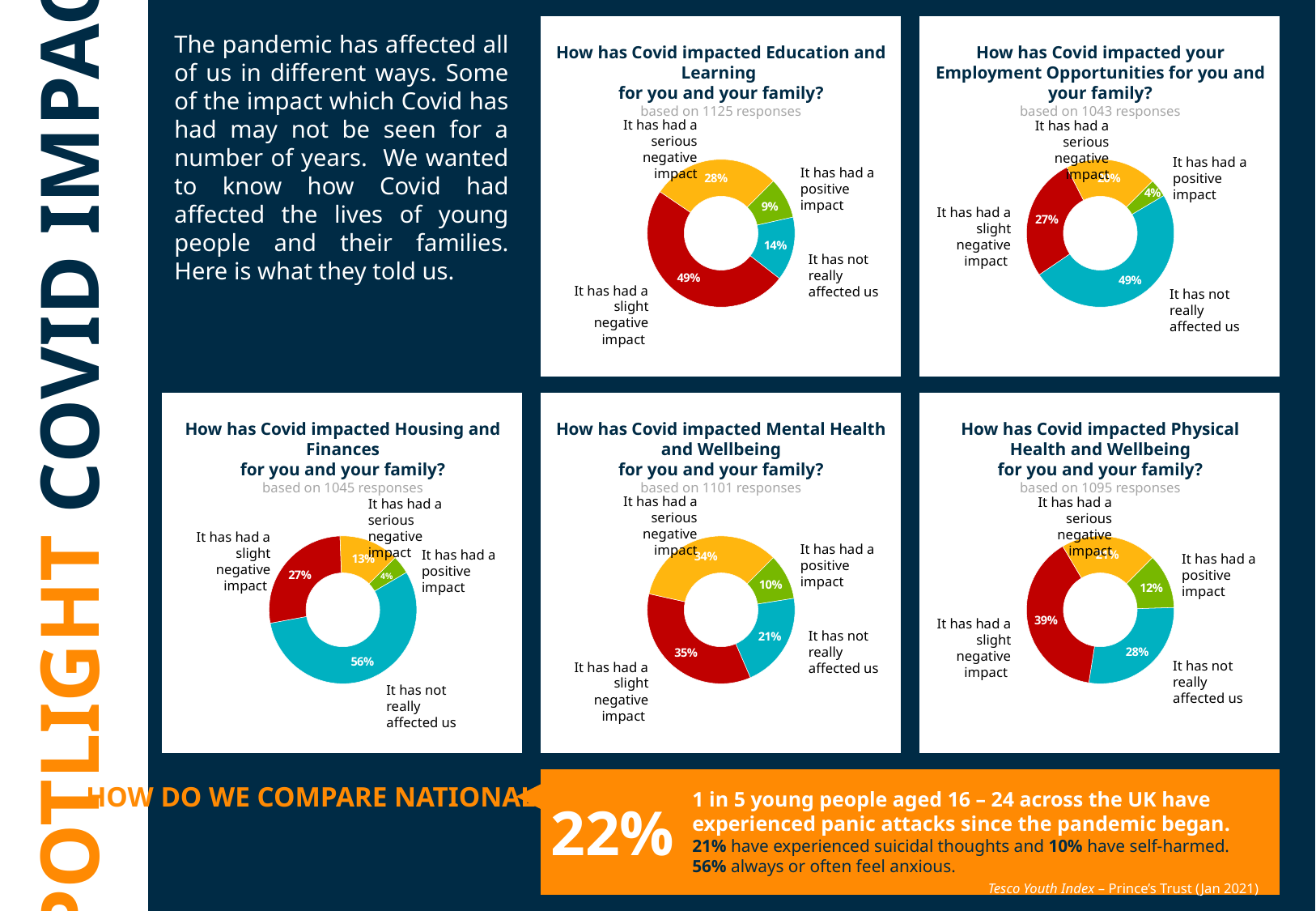
How many response categories does each donut chart on the slide show? 4 In the 'How has Covid impacted your Employment Opportunities' chart, which is larger: the share for 'It has not really affected us' or the share for 'It has had a slight negative impact'? It has not really affected us In the 'How has Covid impacted Mental Health and Wellbeing' chart, what percentage said it has not really affected them? 21% In the 'How has Covid impacted Physical Health and Wellbeing' chart, what percentage said it has had a positive impact? 12% What kind of chart is used for 'How has Covid impacted Housing and Finances'? Donut (pie) chart In the 'How has Covid impacted Physical Health and Wellbeing' chart, what is the difference between the slight negative impact share and the 'not really affected us' share? 11% In the 'How has Covid impacted Mental Health and Wellbeing' chart, what is the difference between the slight negative impact share and the serious negative impact share? 1% In the 'How has Covid impacted Education and Learning' chart, what percentage said it has had a slight negative impact? 49% In the 'How has Covid impacted Housing and Finances' chart, which response has the smallest share? It has had a positive impact In the 'How has Covid impacted Housing and Finances' chart, which response has the largest share? It has not really affected us How many responses is the 'How has Covid impacted Mental Health and Wellbeing' chart based on? 1101 In the 'How has Covid impacted Education and Learning' chart, what percentage said it has had a positive impact? 9%